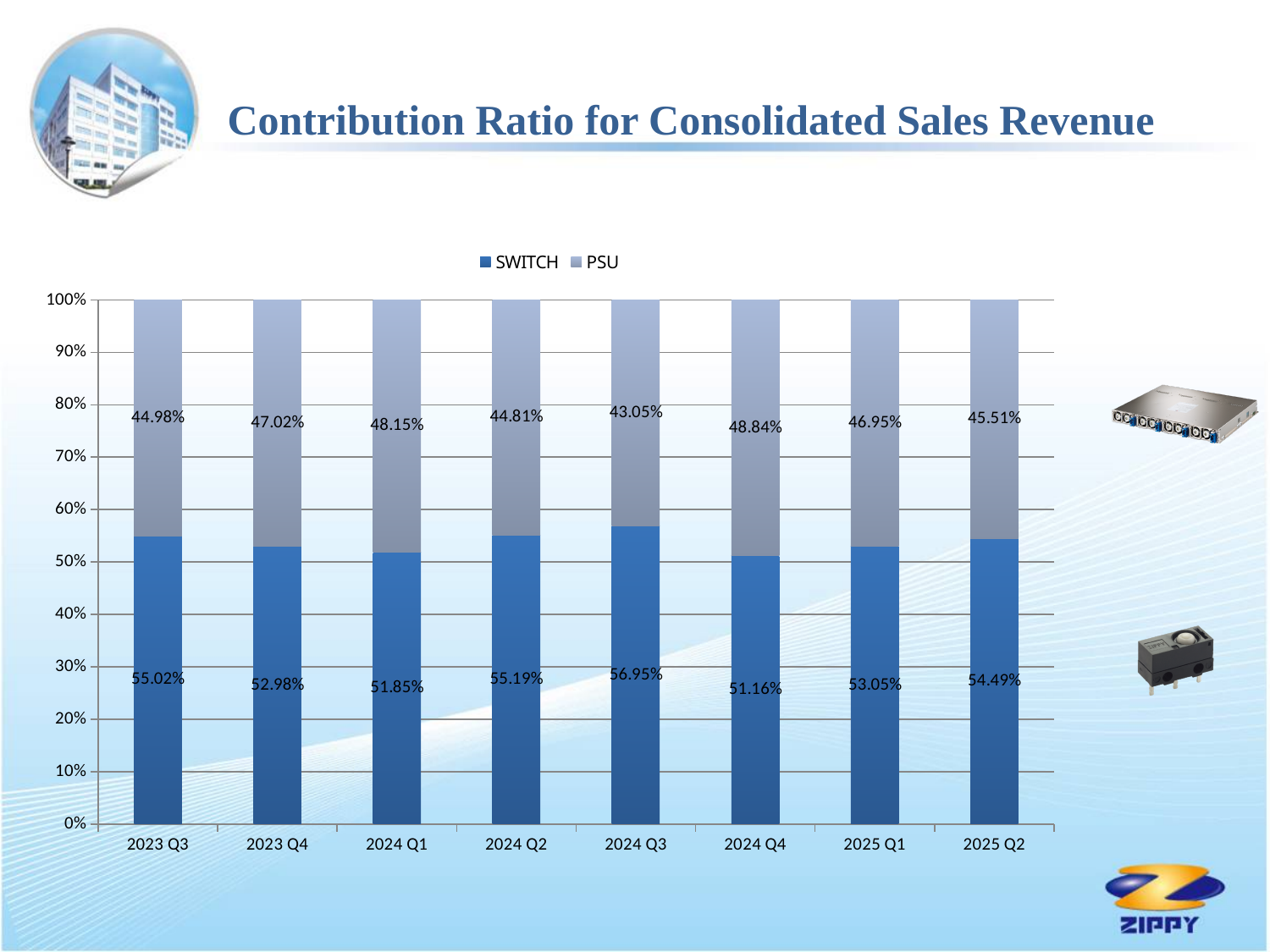
Which is larger in 2024 Q1, the SWITCH ratio or the PSU ratio? SWITCH What is the SWITCH contribution ratio for 2024 Q3? 56.95% What kind of chart is shown on the slide? Stacked bar chart In which quarter is the PSU contribution ratio lowest? 2024 Q3 In which quarter is the SWITCH contribution ratio lowest? 2024 Q4 How many series does the legend list? 2 In which quarter is the SWITCH contribution ratio highest? 2024 Q3 How many quarters are shown on the x axis? 8 What is the SWITCH contribution ratio for 2025 Q2? 54.49% What is the difference between the SWITCH and PSU contribution ratios in 2023 Q3? 10.04% What is the PSU contribution ratio for 2024 Q4? 48.84% What is the title of the slide? Contribution Ratio for Consolidated Sales Revenue